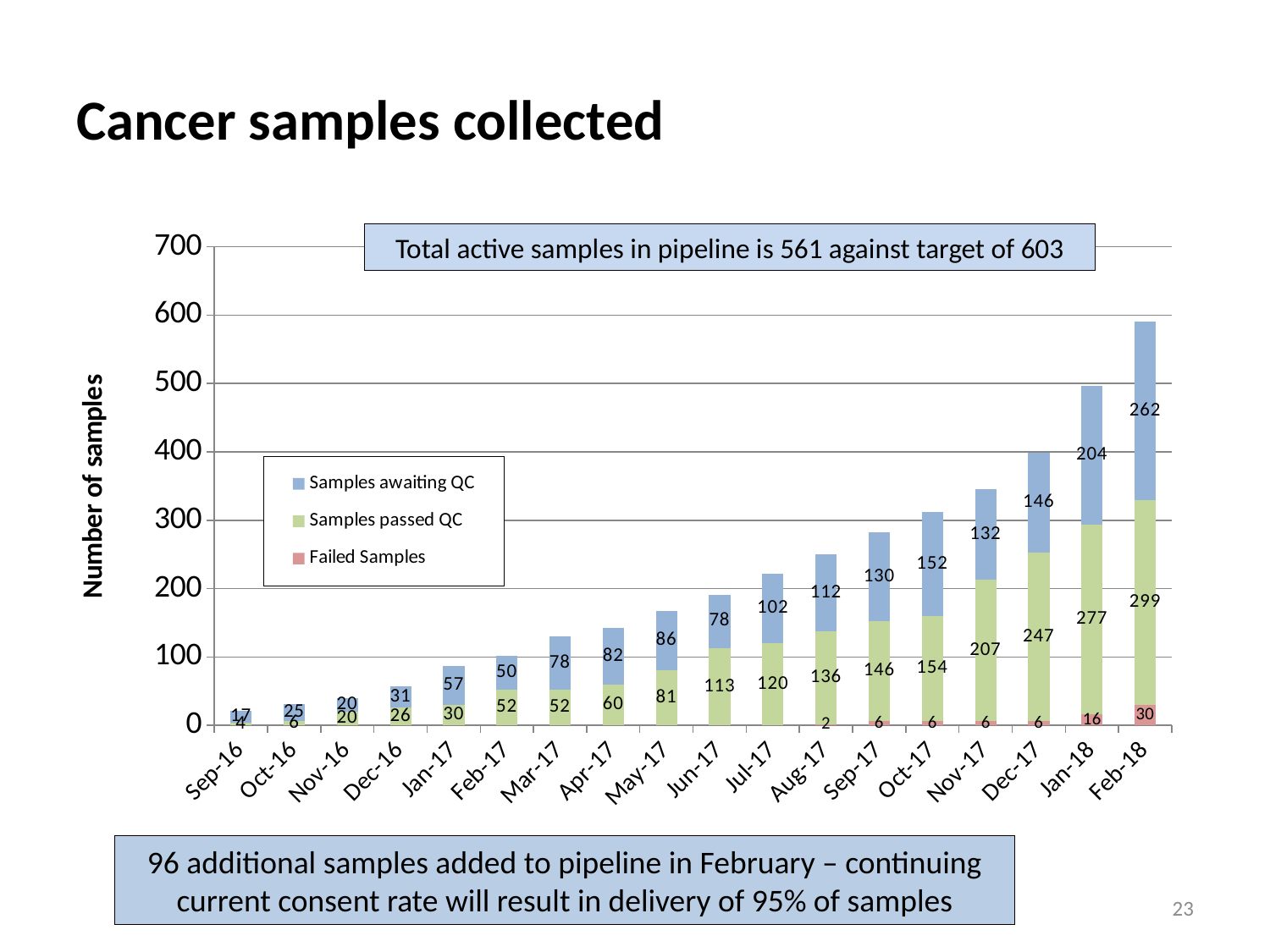
What is the value for Failed Samples in Feb-18? 30 What kind of chart is shown on the slide? stacked bar chart What is the value for Samples passed QC in Nov-17? 207 Which month has the highest value for Samples awaiting QC? Feb-18 What is the total of the stacked bar for Feb-18? 591 Which is larger in Oct-17: Samples awaiting QC or Samples passed QC? Samples passed QC How many series does the legend list? 3 What is the value for Samples awaiting QC in Jan-18? 204 How many months are shown on the x axis? 18 What is the value for Samples passed QC in Feb-18? 299 What is the difference between Samples passed QC in Feb-18 and Jan-18? 22 Do the total samples rise or fall from Sep-16 to Feb-18? rise